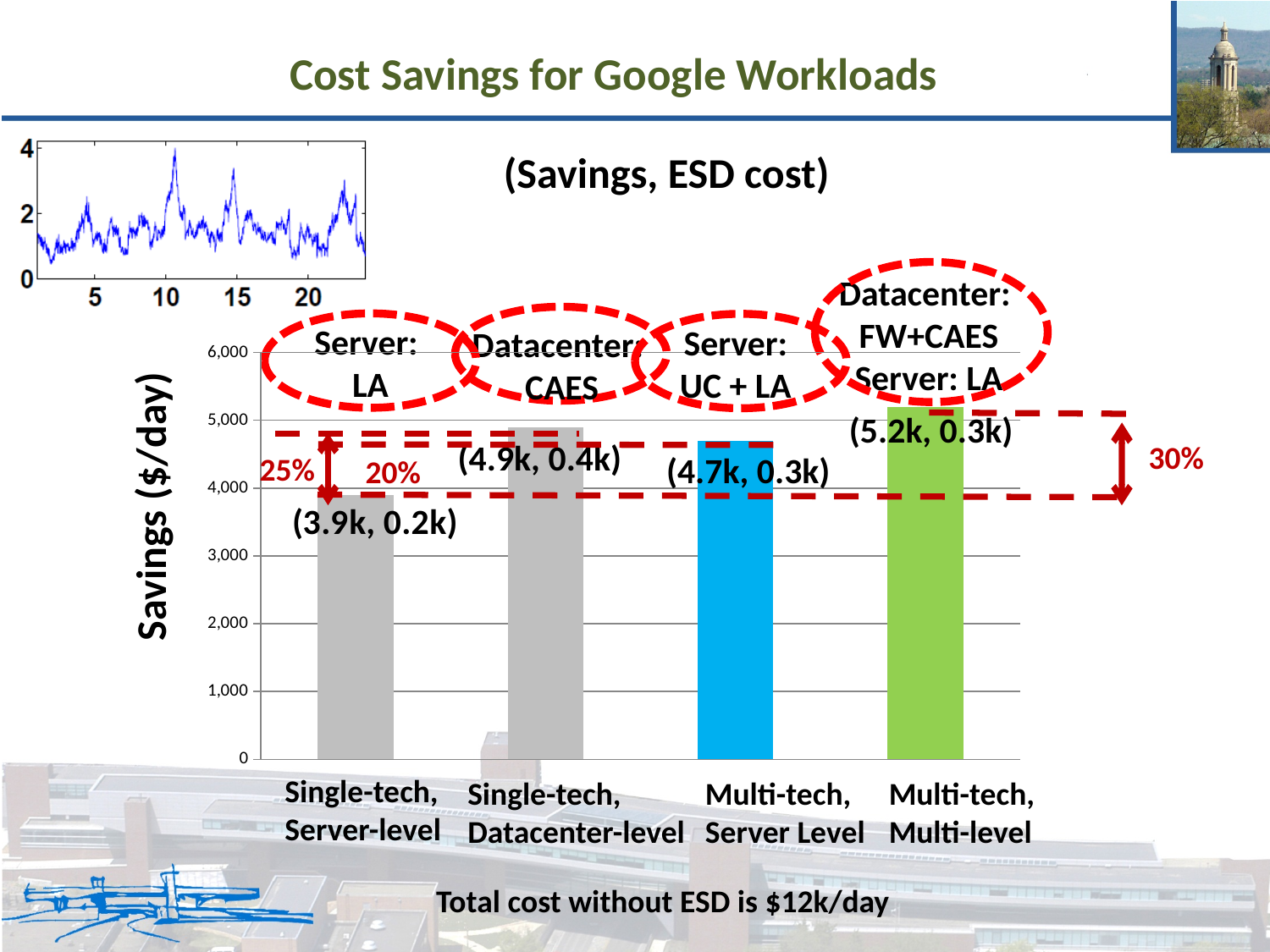
Is the savings value for Multi-tech, Multi-level greater or less than 5,000? greater What is the savings value labelled for the Multi-tech, Multi-level bar? 5.2k What is the savings value labelled for the Single-tech, Server-level bar? 3.9k What is the ESD cost labelled for the Multi-tech, Server Level bar? 0.3k Which has larger savings: Single-tech, Datacenter-level or Multi-tech, Server Level? Single-tech, Datacenter-level What is the label on the vertical axis of the bar chart? Savings ($/day) How many bars does the bar chart show? 4 What type of chart is the main chart on the slide? bar chart What is the difference in savings between Multi-tech, Multi-level and Single-tech, Server-level? 1.3k Which category has the highest savings? Multi-tech, Multi-level Which category has the lowest savings? Single-tech, Server-level What is the savings value labelled for the Single-tech, Datacenter-level bar? 4.9k